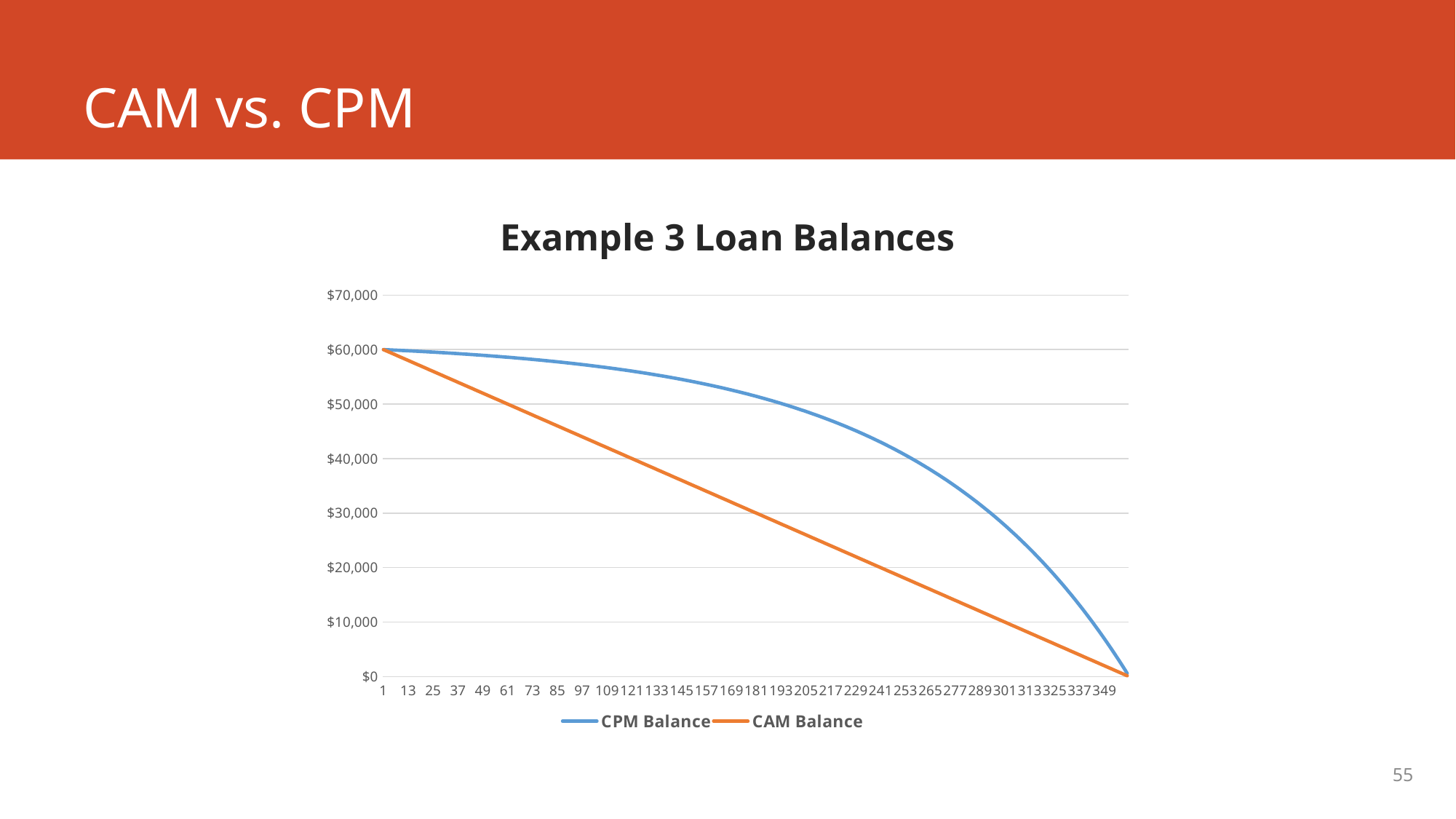
Is the CAM Balance at period 181 greater or less than $40,000? less Do the loan balances rise or fall as the period number increases? Fall What is the CPM Balance at period 1? $60,000 At period 181, which series has the higher balance, CPM Balance or CAM Balance? CPM Balance What is the title of the chart? Example 3 Loan Balances Is the CPM Balance at period 97 greater or less than $50,000? greater At period 289, which series has the higher balance, CPM Balance or CAM Balance? CPM Balance What type of chart is shown on the slide? Line chart What colour is the CAM Balance line? Orange Is the CAM Balance at period 97 greater or less than $50,000? less What is the CAM Balance at period 1? $60,000 How many series does the legend list? 2